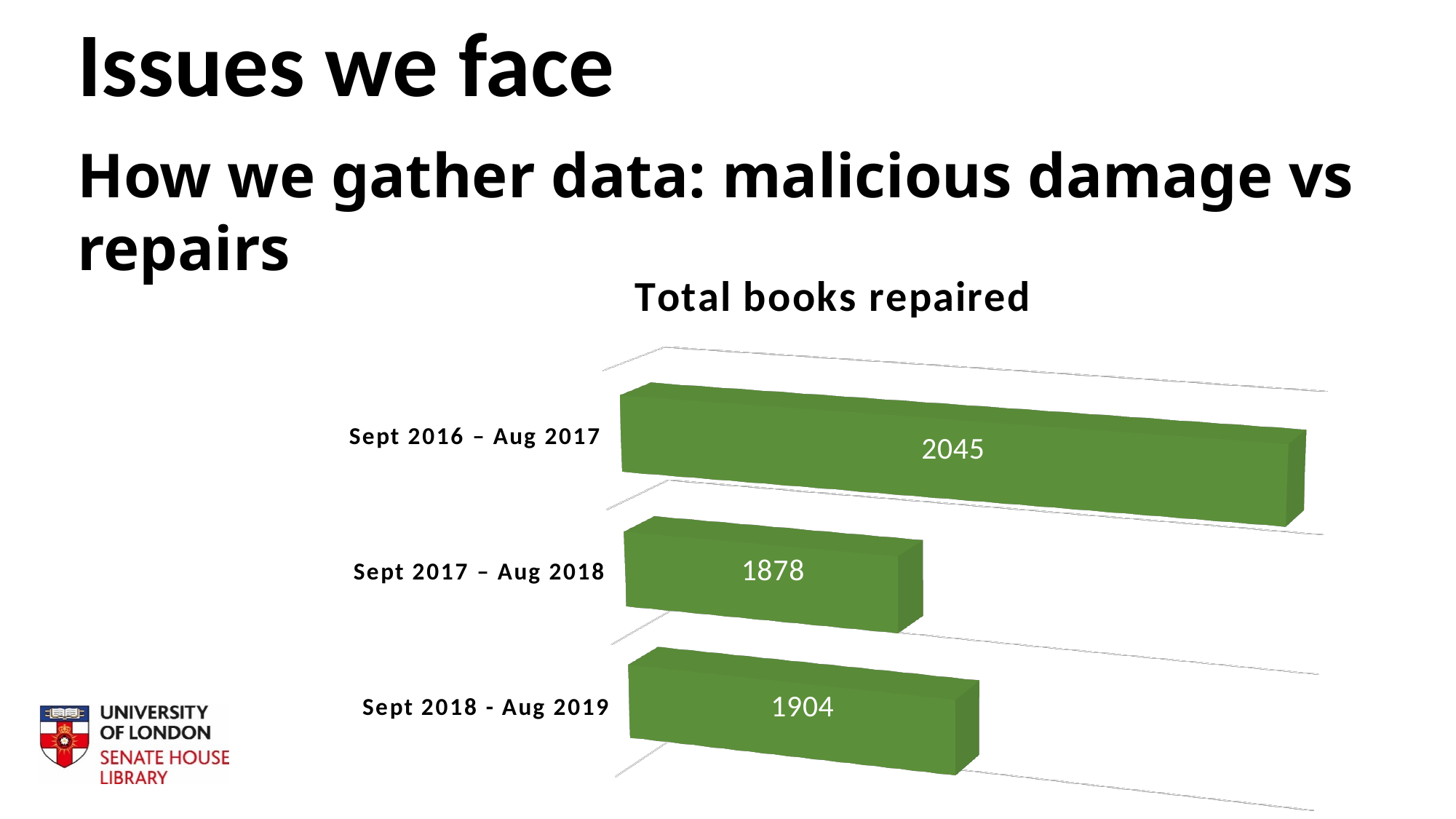
What kind of chart is used to show Total books repaired? Bar chart What is the title of the chart on the slide? Total books repaired How many periods are shown in the Total books repaired chart? 3 Which period had more books repaired: Sept 2017 – Aug 2018 or Sept 2018 - Aug 2019? Sept 2018 - Aug 2019 What is the value for Sept 2017 – Aug 2018 in the Total books repaired chart? 1878 What is the value for Sept 2016 – Aug 2017 in the Total books repaired chart? 2045 What colour are the bars in the Total books repaired chart? Green What is the difference between the books repaired in Sept 2018 - Aug 2019 and Sept 2017 – Aug 2018? 26 What is the value for Sept 2018 - Aug 2019 in the Total books repaired chart? 1904 Which period has the lowest number of books repaired? Sept 2017 – Aug 2018 Which period has the highest number of books repaired? Sept 2016 – Aug 2017 What is the difference between the books repaired in Sept 2016 – Aug 2017 and Sept 2017 – Aug 2018? 167